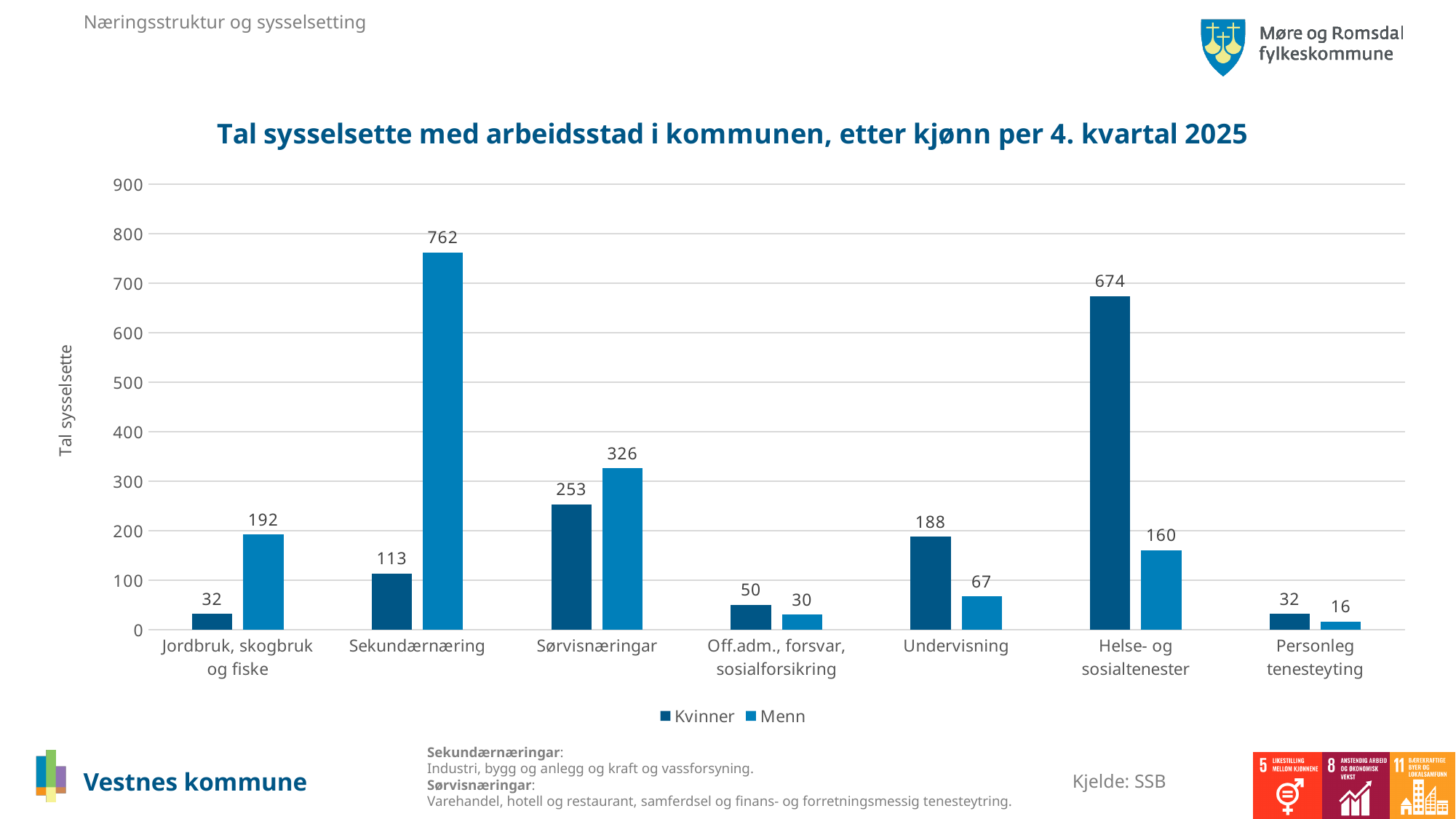
Which category has the highest value for Kvinner? Helse- og sosialtenester What is the difference between Menn and Kvinner in Sørvisnæringar? 73 What is the source cited for the chart? SSB What is the value for Kvinner in Helse- og sosialtenester? 674 How many categories are shown on the x axis? 7 Is the value for Menn in Jordbruk, skogbruk og fiske greater or less than 100? greater Which category has the lowest value for Menn? Personleg tenesteyting What is the value for Kvinner in Undervisning? 188 How many series does the legend list? 2 What is the value for Menn in Sekundærnæring? 762 Which is larger in Off.adm., forsvar, sosialforsikring: Kvinner or Menn? Kvinner What kind of chart is shown on the slide? Bar chart